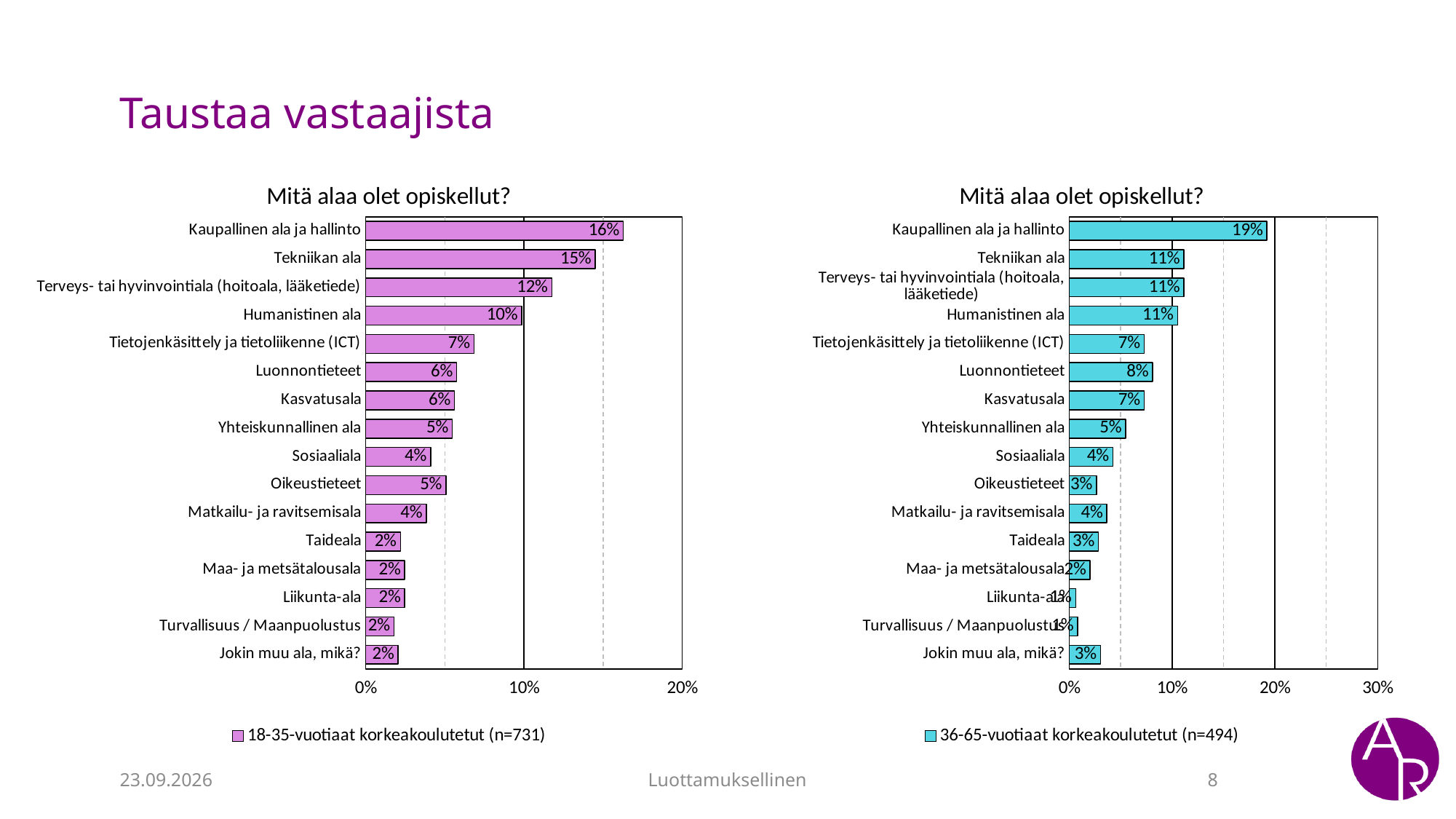
On the left chart (18-35-vuotiaat korkeakoulutetut), which is larger: Tietojenkäsittely ja tietoliikenne (ICT) or Sosiaaliala? Tietojenkäsittely ja tietoliikenne (ICT) On the left chart (18-35-vuotiaat korkeakoulutetut), what is the difference between Kaupallinen ala ja hallinto and Humanistinen ala? 6% What is the legend entry of the left chart? 18-35-vuotiaat korkeakoulutetut (n=731) On the right chart (36-65-vuotiaat korkeakoulutetut), what is the value for Kaupallinen ala ja hallinto? 19% On the right chart (36-65-vuotiaat korkeakoulutetut), what is the difference between Kaupallinen ala ja hallinto and Tekniikan ala? 8% On the right chart (36-65-vuotiaat korkeakoulutetut), what is the value for Luonnontieteet? 8% On the left chart (18-35-vuotiaat korkeakoulutetut), what is the value for Tekniikan ala? 15% On the left chart (18-35-vuotiaat korkeakoulutetut), which category has the highest value? Kaupallinen ala ja hallinto On the left chart (18-35-vuotiaat korkeakoulutetut), what is the value for Kaupallinen ala ja hallinto? 16% What type of chart is the right chart (36-65-vuotiaat korkeakoulutetut)? Bar chart How many categories are shown on the left chart (18-35-vuotiaat korkeakoulutetut)? 16 On the right chart (36-65-vuotiaat korkeakoulutetut), which category has the highest value? Kaupallinen ala ja hallinto